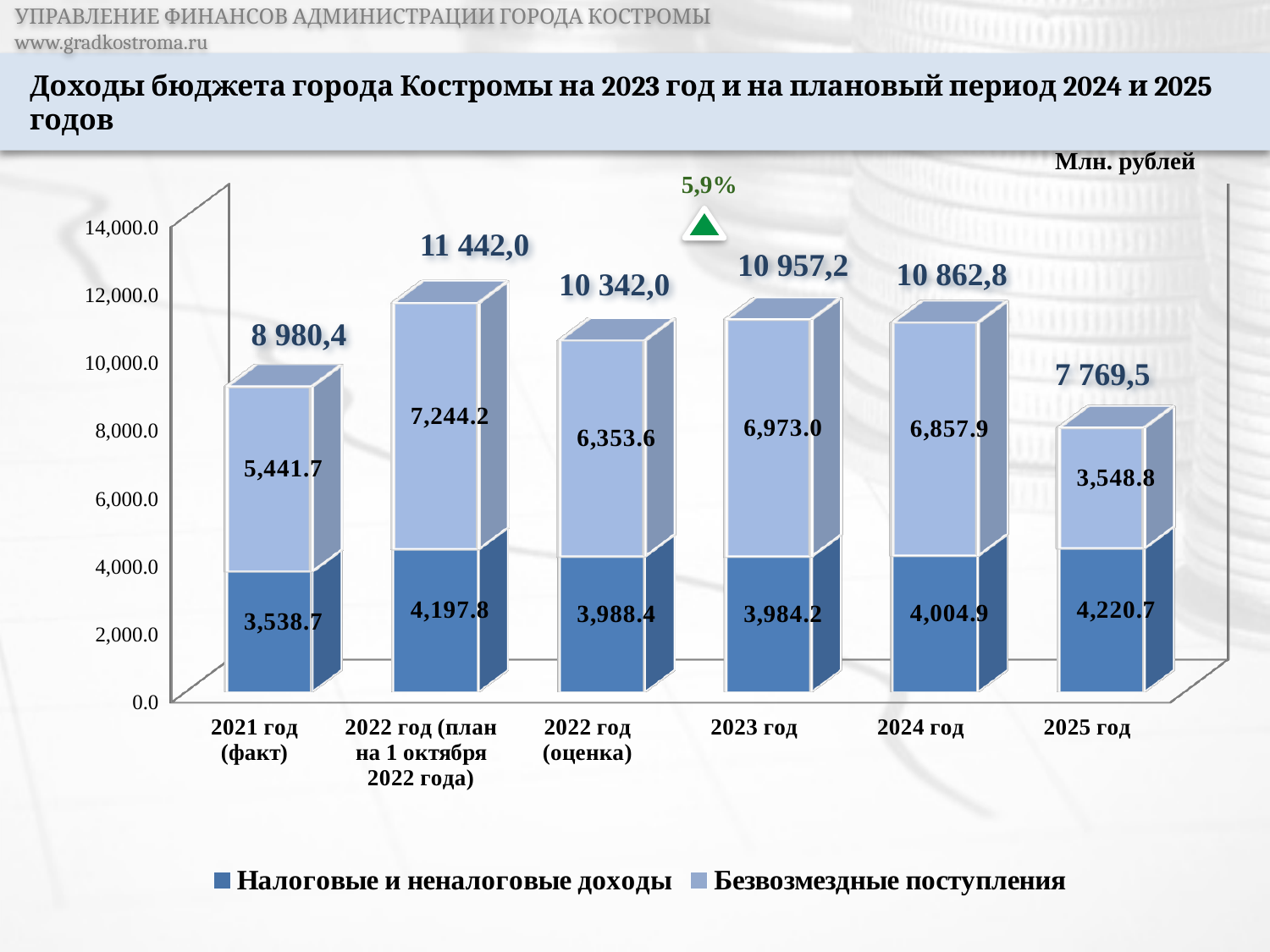
What is the total shown above the bar for 2022 год (план на 1 октября 2022 года)? 11 442,0 Which is larger: Безвозмездные поступления for 2023 год or for 2022 год (оценка)? 2023 год What is the value of Налоговые и неналоговые доходы for 2023 год? 3,984.2 How many categories are shown on the x axis? 6 Which category has the lowest total bar? 2025 год Which category has the lowest value for Безвозмездные поступления? 2025 год What is the difference between Безвозмездные поступления for 2023 год and 2024 год? 115.1 What is the total shown above the bar for 2021 год (факт)? 8 980,4 Which category has the highest total bar? 2022 год (план на 1 октября 2022 года) What is the value of Безвозмездные поступления for 2025 год? 3,548.8 What unit is indicated for the values in the chart? Млн. рублей How many series does the legend list? 2